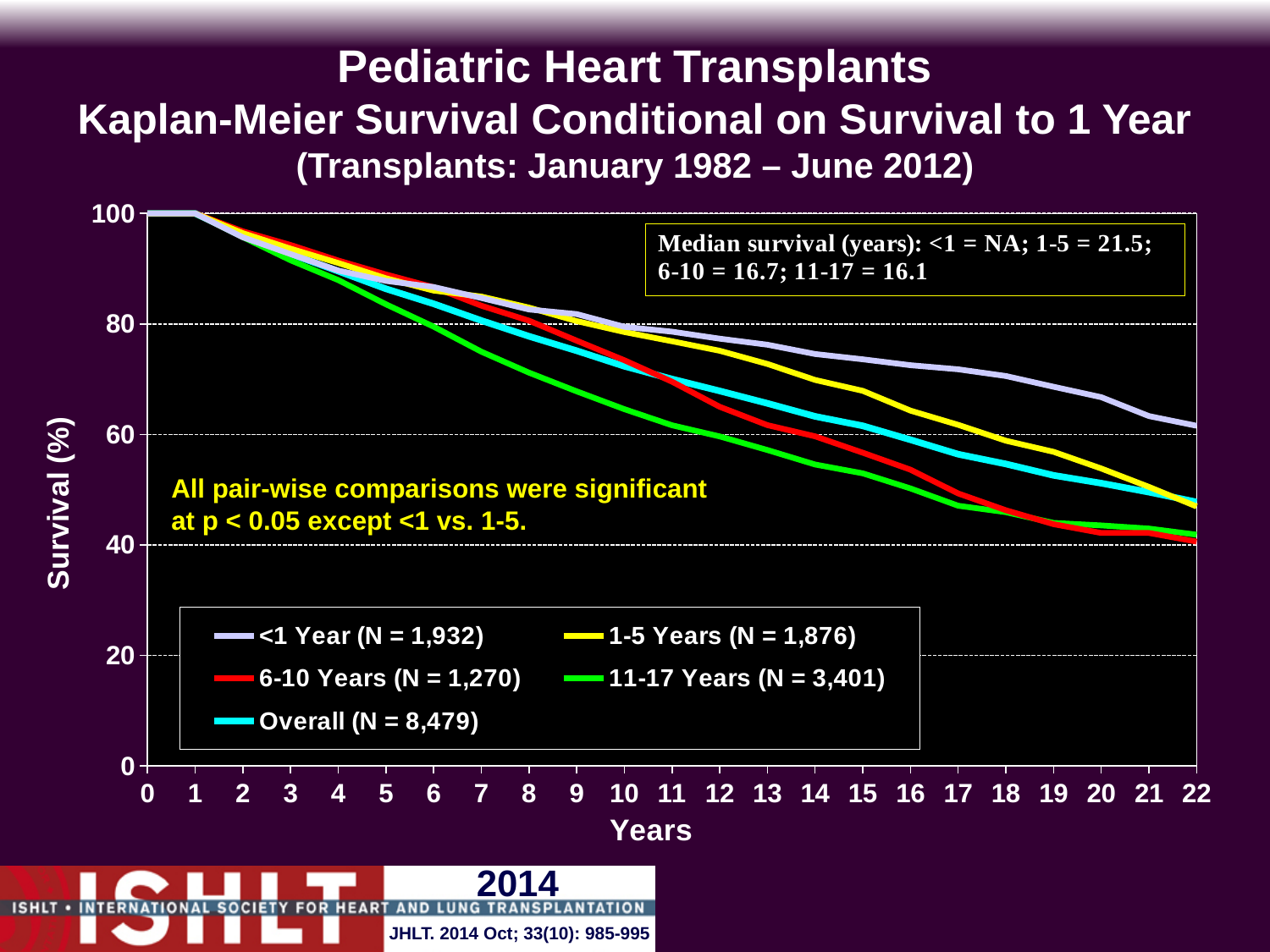
What is the median survival in years for the 11-17 Years group, as stated in the text box? 16.1 Is the survival for the <1 Year group at 20 years greater or less than 60? greater Is the survival for the 1-5 Years group at 22 years greater or less than 60? less How many series does the legend list? 5 What kind of chart is shown on the slide? line chart What is the median survival given for the <1 Year group in the text box? NA Which group has the lowest survival at 10 years? 11-17 Years Do the survival curves rise or fall as years increase? fall What is the median survival in years for the 1-5 Years group, as stated in the text box? 21.5 What is the N for the Overall group shown in the legend? 8,479 Which group has the highest survival at 20 years? <1 Year What is the median survival in years for the 6-10 Years group, as stated in the text box? 16.7